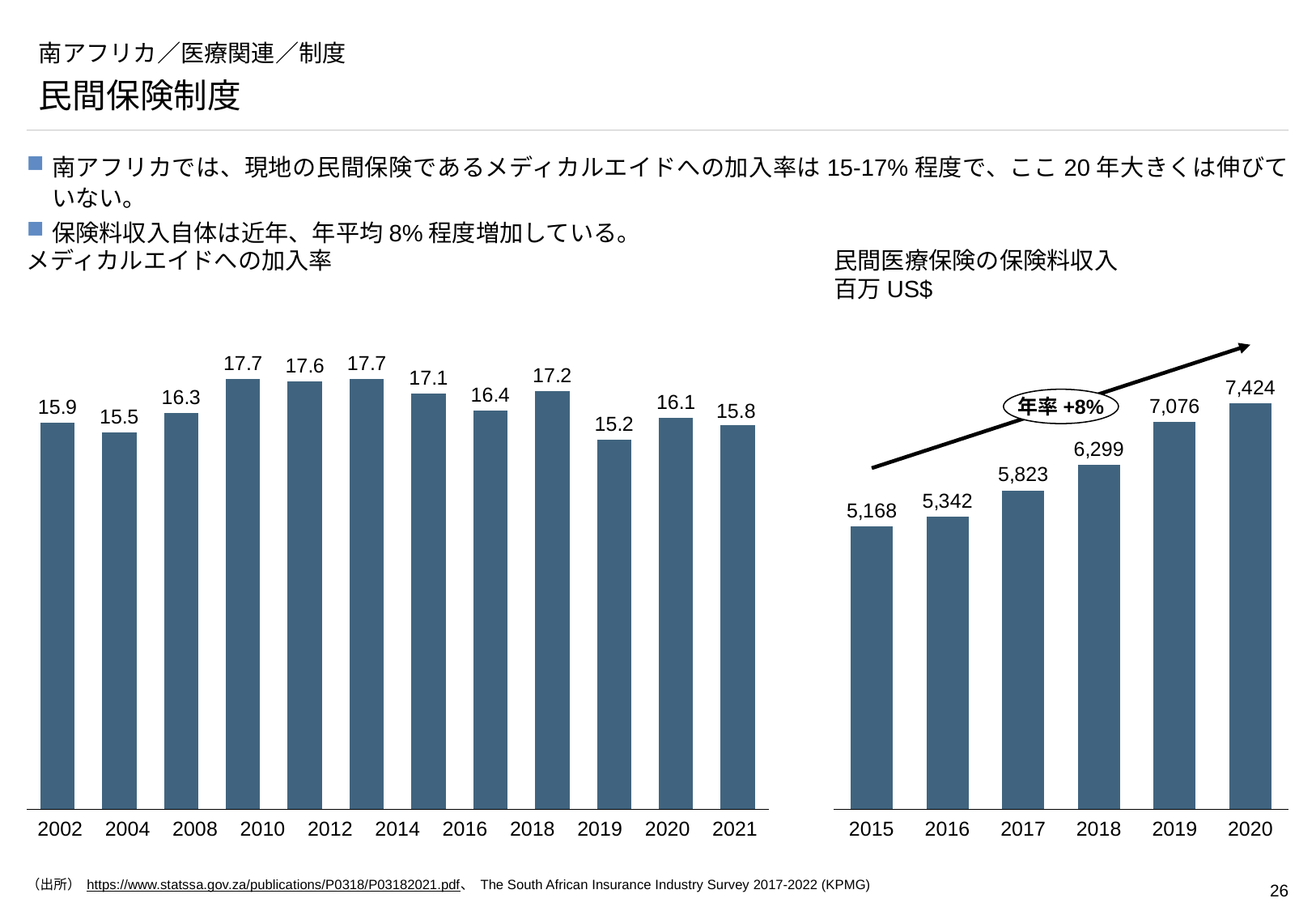
In the right chart (民間医療保険の保険料収入), what is the value for 2018? 6,299 In the right chart (民間医療保険の保険料収入), how many years are shown? 6 In the right chart (民間医療保険の保険料収入), what annual growth rate is written in the oval label? 年率 +8% In the right chart (民間医療保険の保険料収入), do the values rise or fall from 2015 to 2020? rise In the right chart (民間医療保険の保険料収入), which year has the highest value? 2020 In the right chart (民間医療保険の保険料収入), what is the difference between the 2020 and 2019 values? 348 In the right chart (民間医療保険の保険料収入), which year has the lowest value? 2015 In the left chart (メディカルエイドへの加入率), what is the lowest value shown? 15.2 What kind of chart is the left chart (メディカルエイドへの加入率)? bar chart In the left chart (メディカルエイドへの加入率), what is the value of the rightmost bar (2021)? 15.8 In the right chart (民間医療保険の保険料収入), what is the value for 2015? 5,168 In the left chart (メディカルエイドへの加入率), what is the value of the leftmost bar (2002)? 15.9